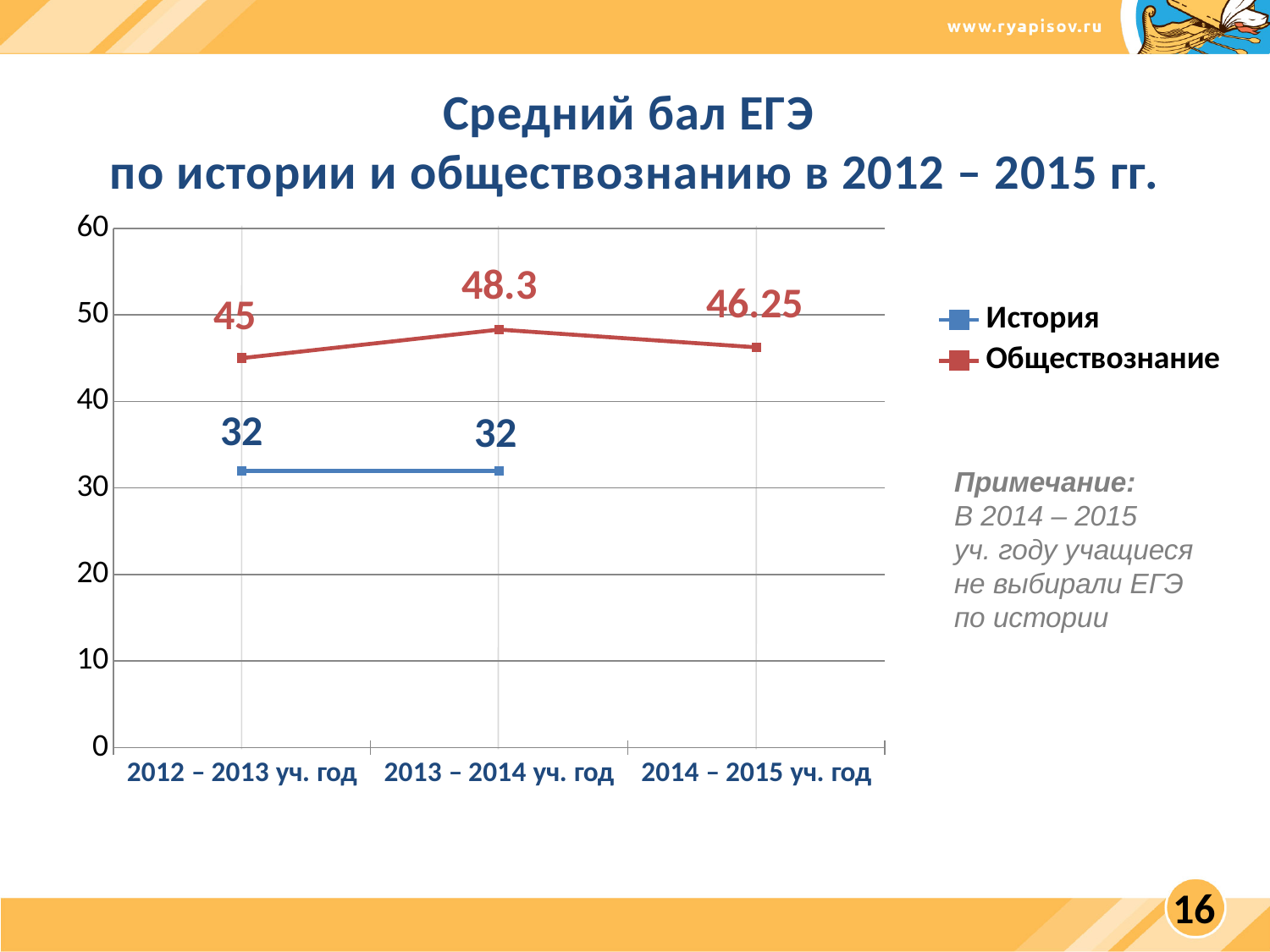
What is the value for История in 2012 – 2013 уч. год? 32 What kind of chart is shown on the slide? line chart What is the value for Обществознание in 2013 – 2014 уч. год? 48.3 What is the difference between the Обществознание values in 2013 – 2014 уч. год and 2012 – 2013 уч. год? 3.3 What is the value for Обществознание in 2014 – 2015 уч. год? 46.25 How many series does the legend list? 2 In which academic year is the value for Обществознание lowest? 2012 – 2013 уч. год Which series has the larger value in 2013 – 2014 уч. год, История or Обществознание? Обществознание In which academic year is the value for Обществознание highest? 2013 – 2014 уч. год What is the value for Обществознание in 2012 – 2013 уч. год? 45 How many academic years are shown on the x axis? 3 Is the value for Обществознание in 2014 – 2015 уч. год greater or less than 40? greater